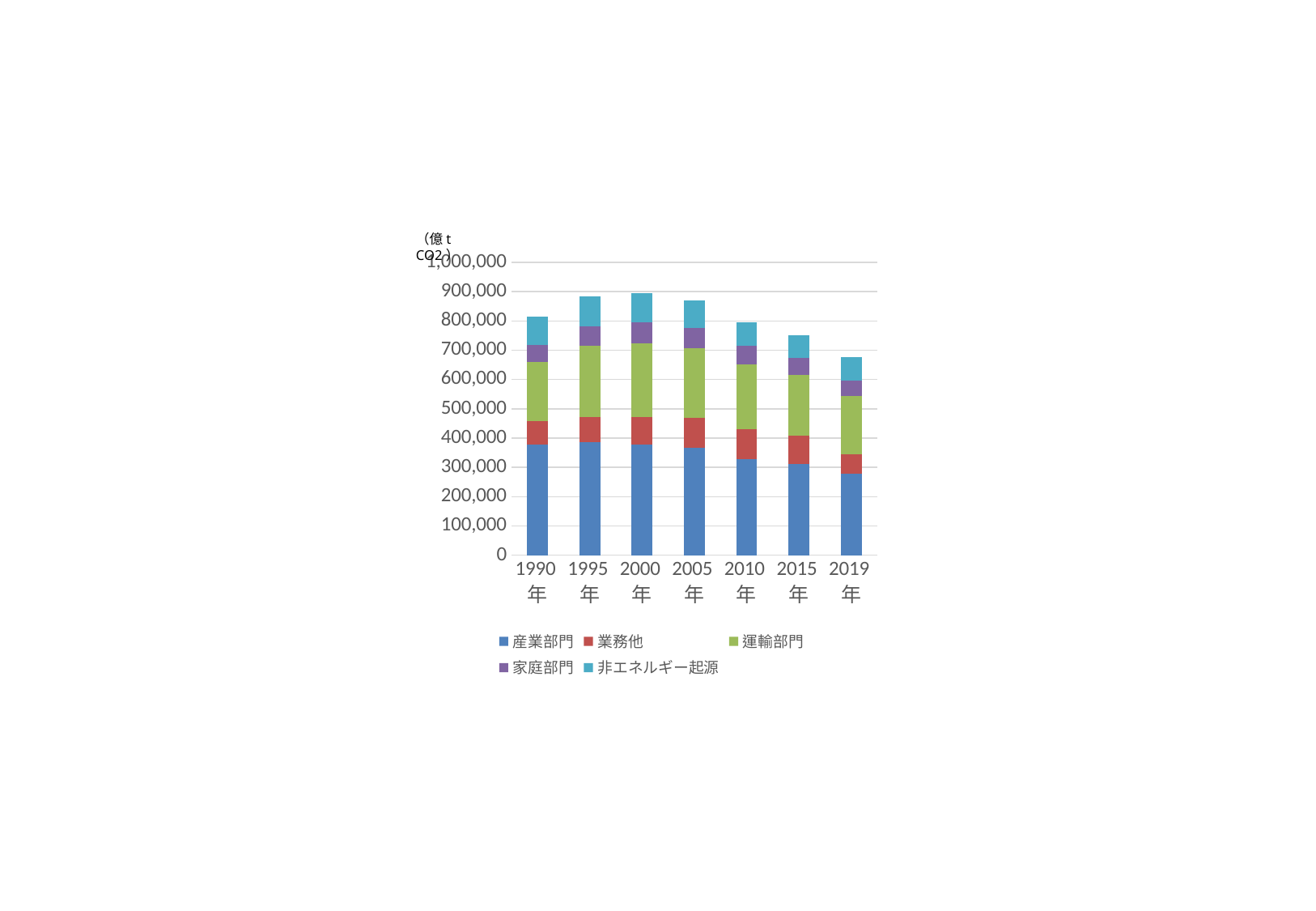
How many series does the legend list? 5 Is the total for 2019年 greater or less than 700,000? less How many years (categories) are shown on the x axis? 7 Which has the larger total, 1990年 or 2019年? 1990年 Is the total for 2000年 greater or less than 800,000? greater From 2005年 to 2019年, do the total bar heights rise or fall? fall Which year has the lowest total stacked bar? 2019年 Which series is shown at the bottom of each stacked bar (blue)? 産業部門 What kind of chart is shown on the slide? Stacked bar chart Which series is listed last in the legend? 非エネルギー起源 Is the total for 2015年 greater or less than 800,000? less